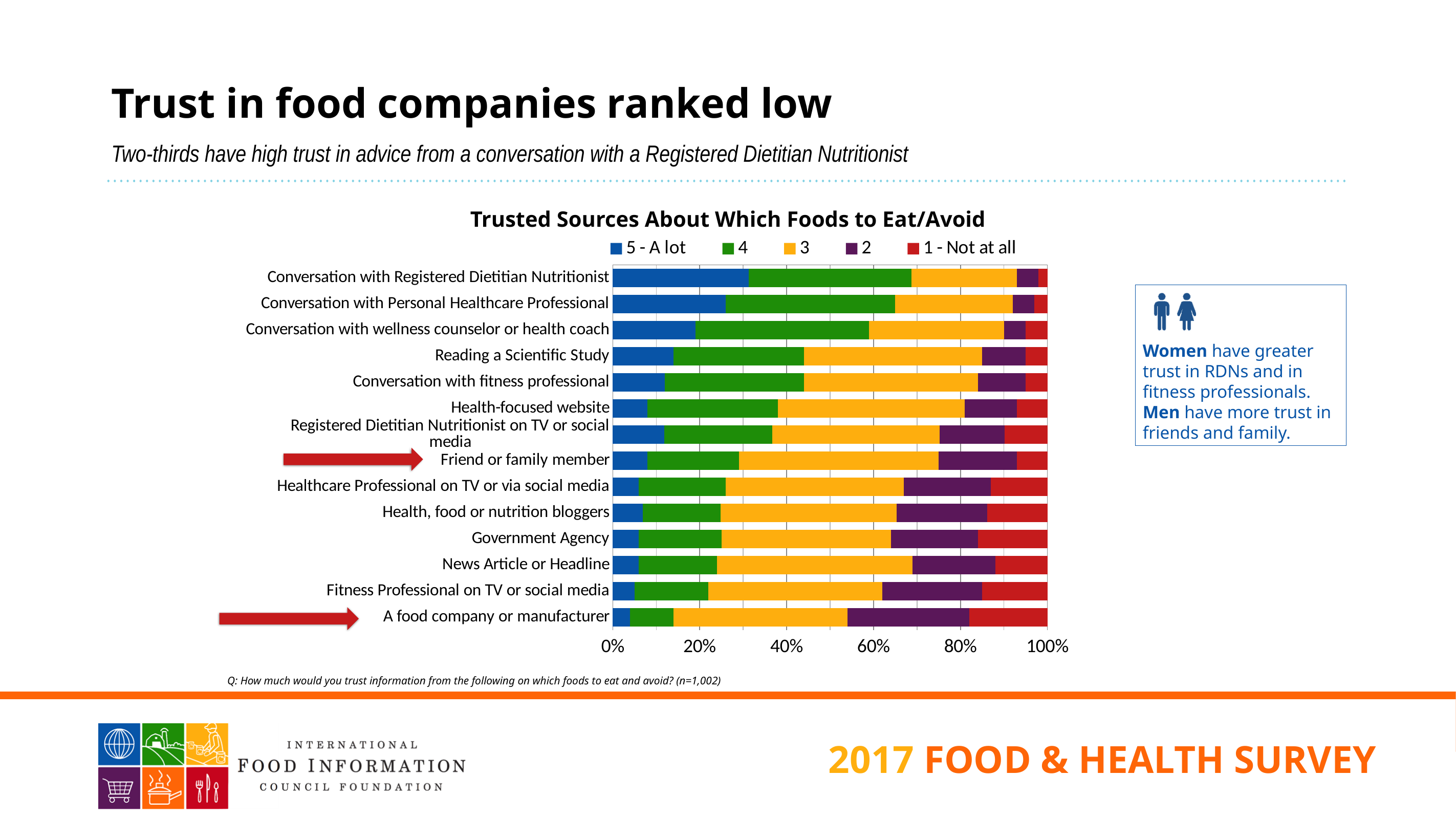
Which legend entry is shown in red? 1 - Not at all Which has a larger '4' segment: Conversation with Personal Healthcare Professional or A food company or manufacturer? Conversation with Personal Healthcare Professional Which source has the largest '1 - Not at all' segment? A food company or manufacturer What kind of chart is shown on the slide? stacked bar chart What is the title of the chart? Trusted Sources About Which Foods to Eat/Avoid How many series does the chart's legend list? 5 Which source has the largest '5 - A lot' segment? Conversation with Registered Dietitian Nutritionist Is the '5 - A lot' value for A food company or manufacturer greater or less than 20%? less Which source has the smallest '5 - A lot' segment? A food company or manufacturer Which has a larger '1 - Not at all' segment: Government Agency or Conversation with Registered Dietitian Nutritionist? Government Agency How many sources (categories) are plotted in the chart? 14 Is the '5 - A lot' value for Conversation with Registered Dietitian Nutritionist greater or less than 20%? greater